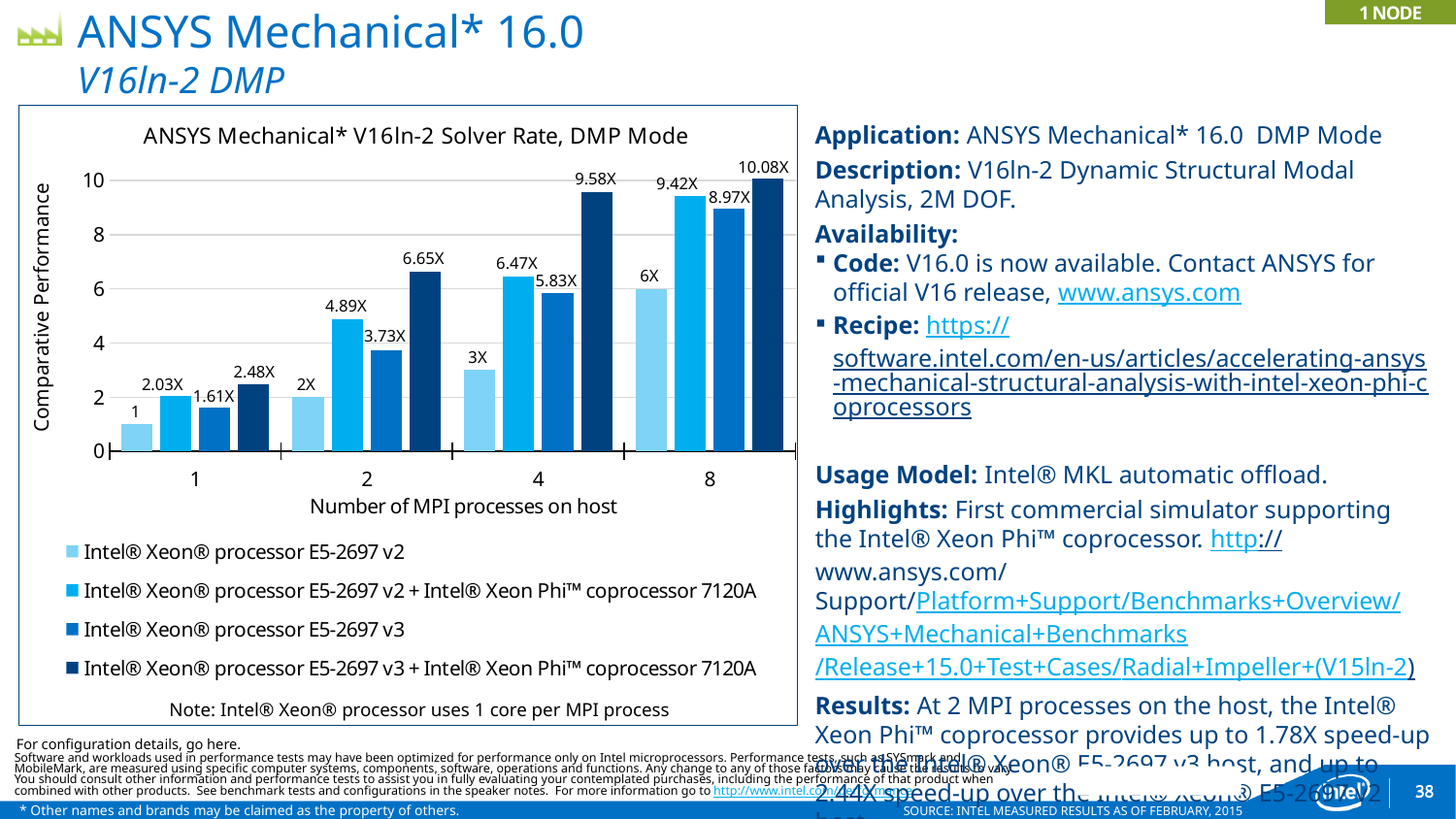
At 1 MPI process on host, which is larger: the value for Intel® Xeon® processor E5-2697 v2 + Intel® Xeon Phi™ coprocessor 7120A or the value for Intel® Xeon® processor E5-2697 v3? Intel® Xeon® processor E5-2697 v2 + Intel® Xeon Phi™ coprocessor 7120A What type of chart is shown on the slide? bar chart What is the value for Intel® Xeon® processor E5-2697 v2 + Intel® Xeon Phi™ coprocessor 7120A at 2 MPI processes on host? 4.89X Which series has the highest value at 4 MPI processes on host? Intel® Xeon® processor E5-2697 v3 + Intel® Xeon Phi™ coprocessor 7120A What is the value for Intel® Xeon® processor E5-2697 v3 at 4 MPI processes on host? 5.83X What is the value for Intel® Xeon® processor E5-2697 v3 + Intel® Xeon Phi™ coprocessor 7120A at 8 MPI processes on host? 10.08X Which series has the lowest value at 8 MPI processes on host? Intel® Xeon® processor E5-2697 v2 How many series does the legend list? 4 How many categories (numbers of MPI processes on host) are shown on the x axis? 4 What is the difference between the Intel® Xeon® processor E5-2697 v3 + Intel® Xeon Phi™ coprocessor 7120A value and the Intel® Xeon® processor E5-2697 v3 value at 2 MPI processes on host? 2.92X What is the title of the chart? ANSYS Mechanical* V16ln-2 Solver Rate, DMP Mode Do the values for Intel® Xeon® processor E5-2697 v2 rise or fall as the number of MPI processes on host increases? rise